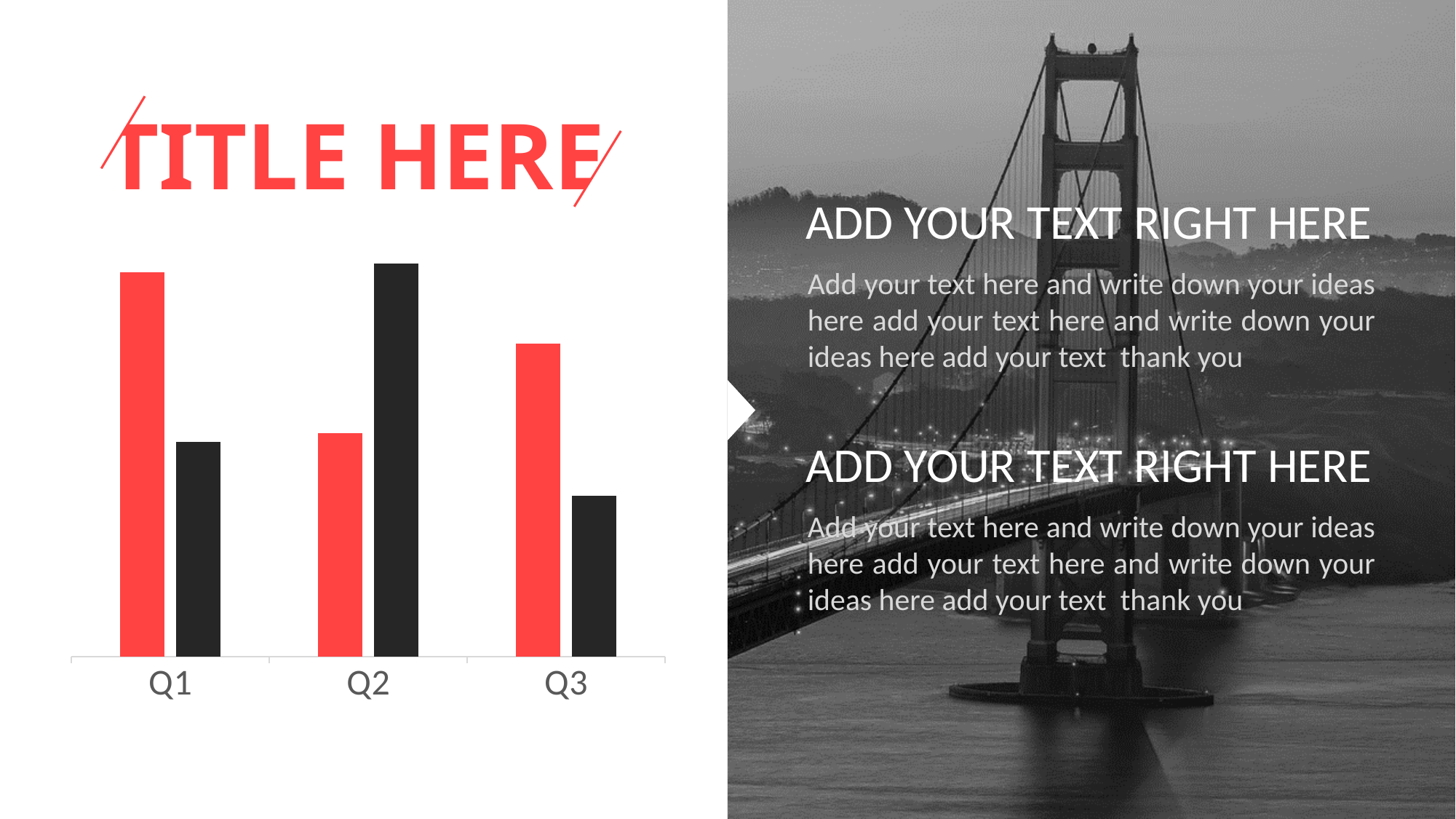
Among the red bars, which category has the shortest bar? Q2 How many categories are shown on the x axis of the chart? 3 In the Q3 category, which bar is taller, the red bar or the black bar? the red bar In the Q1 category, which bar is taller, the red bar or the black bar? the red bar In the Q2 category, which bar is taller, the red bar or the black bar? the black bar Among the red bars, which category has the tallest bar? Q1 Among the black bars, which category has the tallest bar? Q2 What kind of chart is shown on the slide? bar chart Among the black bars, which category has the shortest bar? Q3 Does the red bar rise or fall from Q1 to Q2? fall How many bars are plotted for each category in the chart? 2 What two colours are used for the bars in the chart? red and black